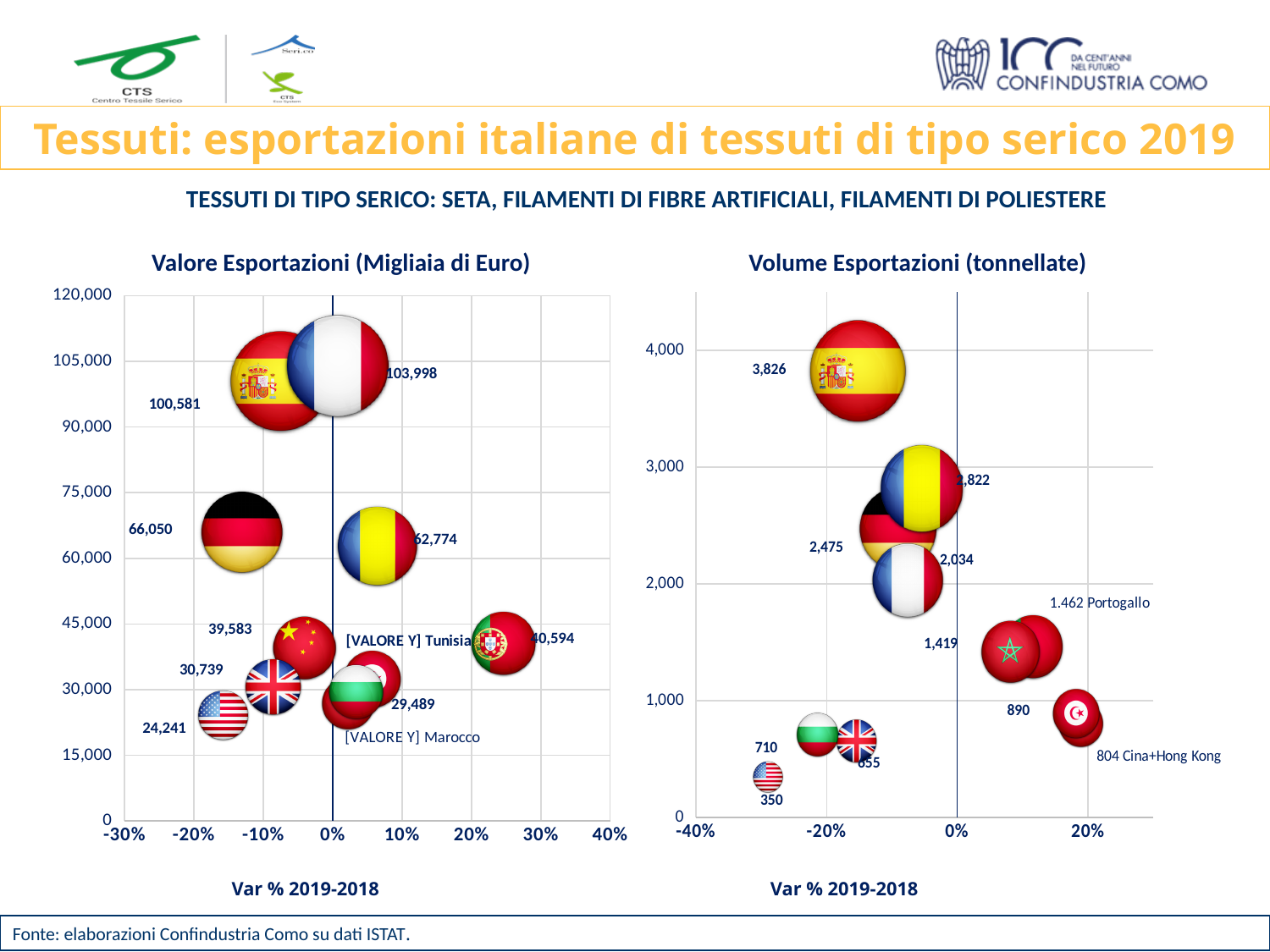
In the 'Volume Esportazioni (tonnellate)' chart, what value is labelled for Portogallo? 1.462 What is the title of the chart on the right of the slide? Volume Esportazioni (tonnellate) How many labelled data values are shown in the 'Volume Esportazioni (tonnellate)' chart? 11 What is the x-axis label of the 'Valore Esportazioni (Migliaia di Euro)' chart? Var % 2019-2018 What kind of chart is the 'Valore Esportazioni (Migliaia di Euro)' chart? bubble chart In the 'Valore Esportazioni (Migliaia di Euro)' chart, what is the lowest labelled value? 24,241 In the 'Volume Esportazioni (tonnellate)' chart, what is the highest labelled value? 3,826 In the 'Valore Esportazioni (Migliaia di Euro)' chart, what is the difference between the two highest labelled values, 103,998 and 100,581? 3,417 In the 'Volume Esportazioni (tonnellate)' chart, what is the lowest labelled value? 350 In the 'Valore Esportazioni (Migliaia di Euro)' chart, which is larger: the value labelled 66,050 (German flag) or the value labelled 62,774 (Romanian flag)? 66,050 In the 'Volume Esportazioni (tonnellate)' chart, what value is labelled for Cina+Hong Kong? 804 In the 'Valore Esportazioni (Migliaia di Euro)' chart, what is the highest labelled value? 103,998